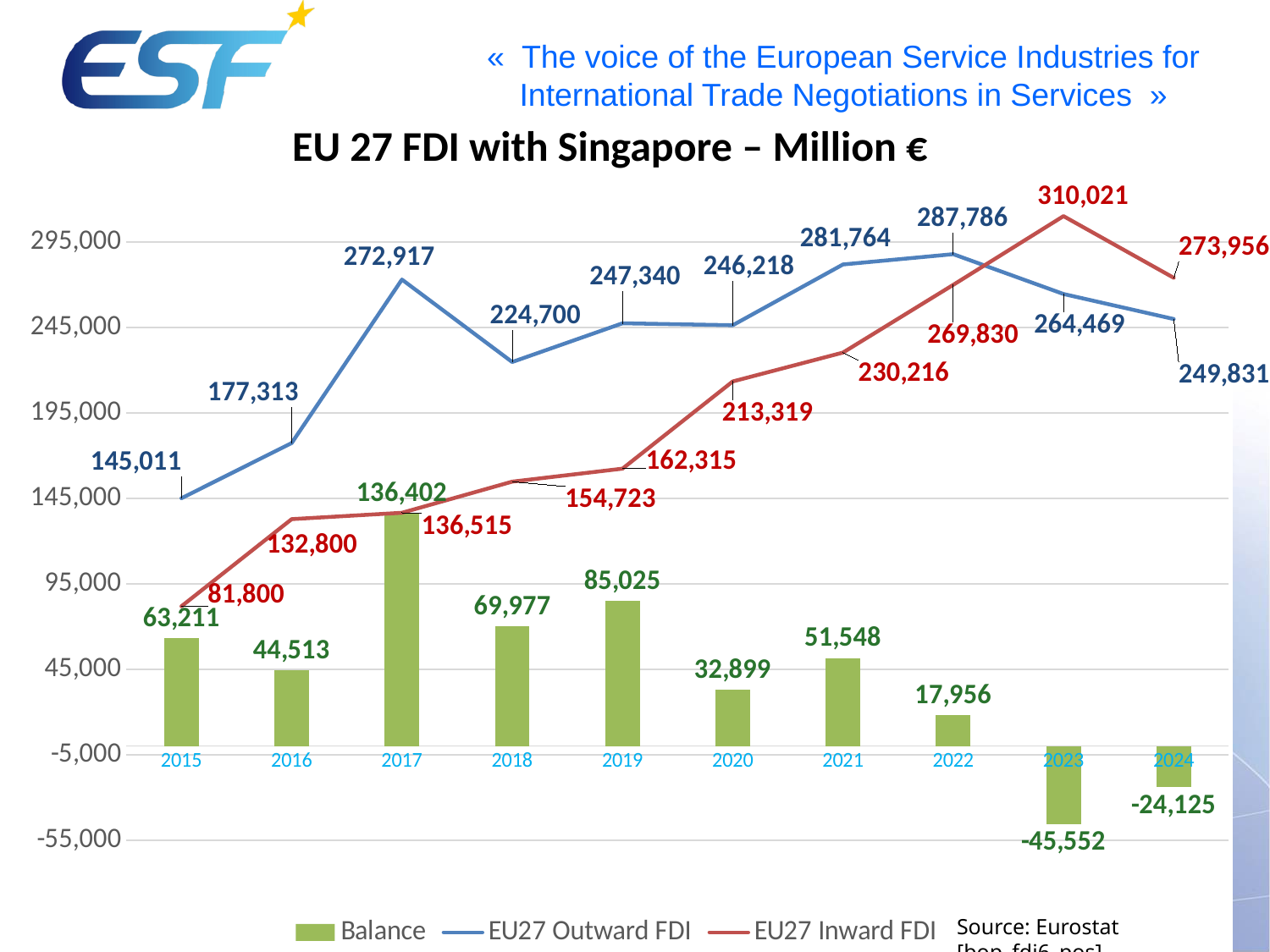
In which year is the EU27 Inward FDI highest? 2023 Does the EU27 Inward FDI rise or fall from 2015 to 2023? Rise How many series does the legend list? 3 What is the EU27 Inward FDI value for 2020? 213,319 What is the Balance value for 2023? -45,552 What is the difference between EU27 Outward FDI and EU27 Inward FDI in 2024? -24,125 Which is larger in 2021, EU27 Outward FDI or EU27 Inward FDI? EU27 Outward FDI In which year is the EU27 Outward FDI highest? 2022 What kind of chart is this? Combined bar and line chart What is the EU27 Outward FDI value for 2017? 272,917 How many years are shown on the x axis? 10 In which year is the Balance lowest? 2023